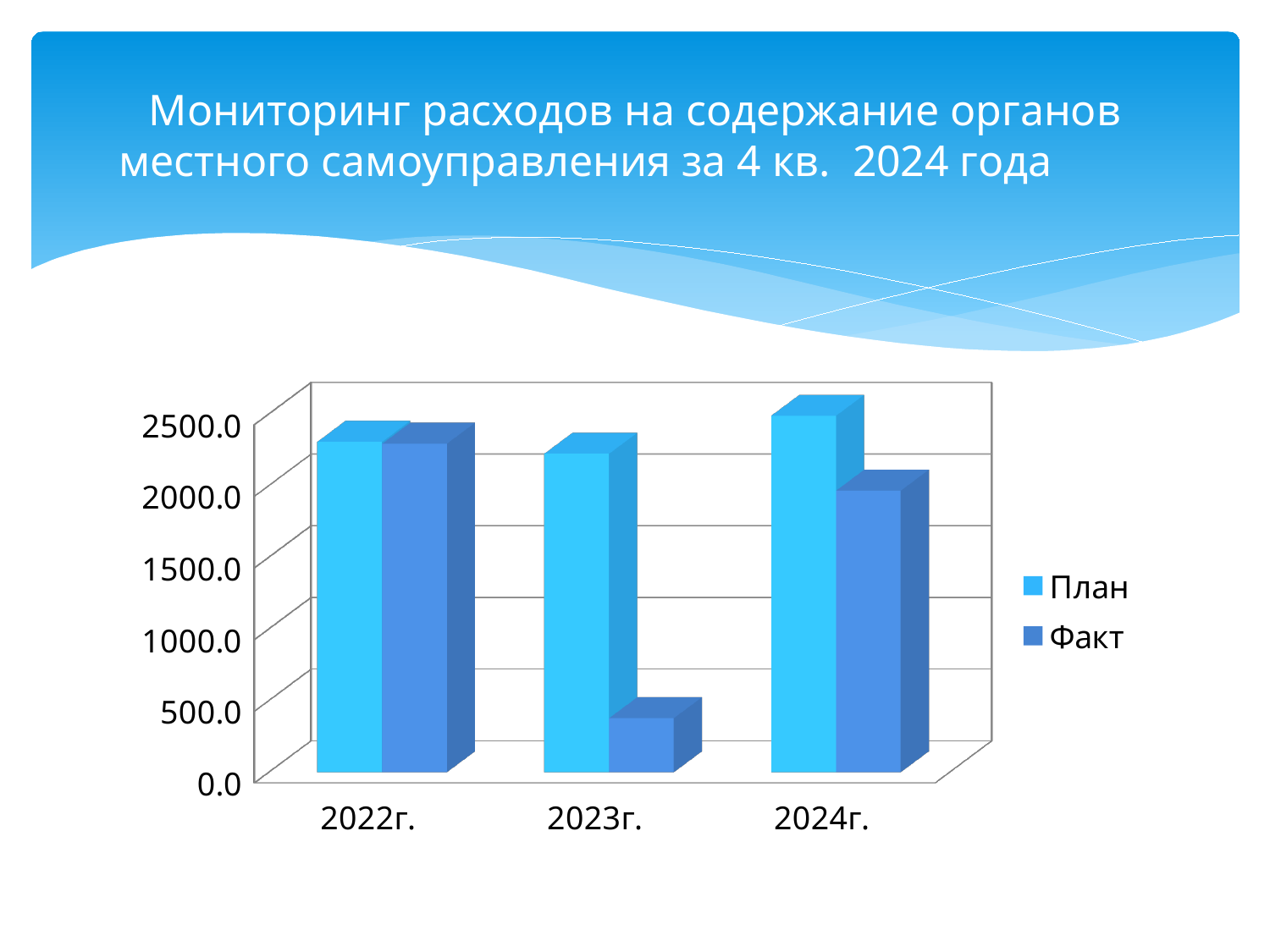
Is the План value for 2023г. greater or less than 2000.0? greater How many year categories are shown on the x axis? 3 Which year has the lowest Факт value? 2023г. Is the План value for 2024г. greater or less than 2000.0? greater For 2024г., which is larger, План or Факт? План Does the Факт series rise or fall from 2022г. to 2024г.? It falls Is the Факт value for 2023г. greater or less than 1000.0? less How many series does the legend list? 2 What are the two series named in the legend? План and Факт Which year has the highest План value? 2024г. For 2023г., which is larger, План or Факт? План What kind of chart is shown on the slide? Bar chart